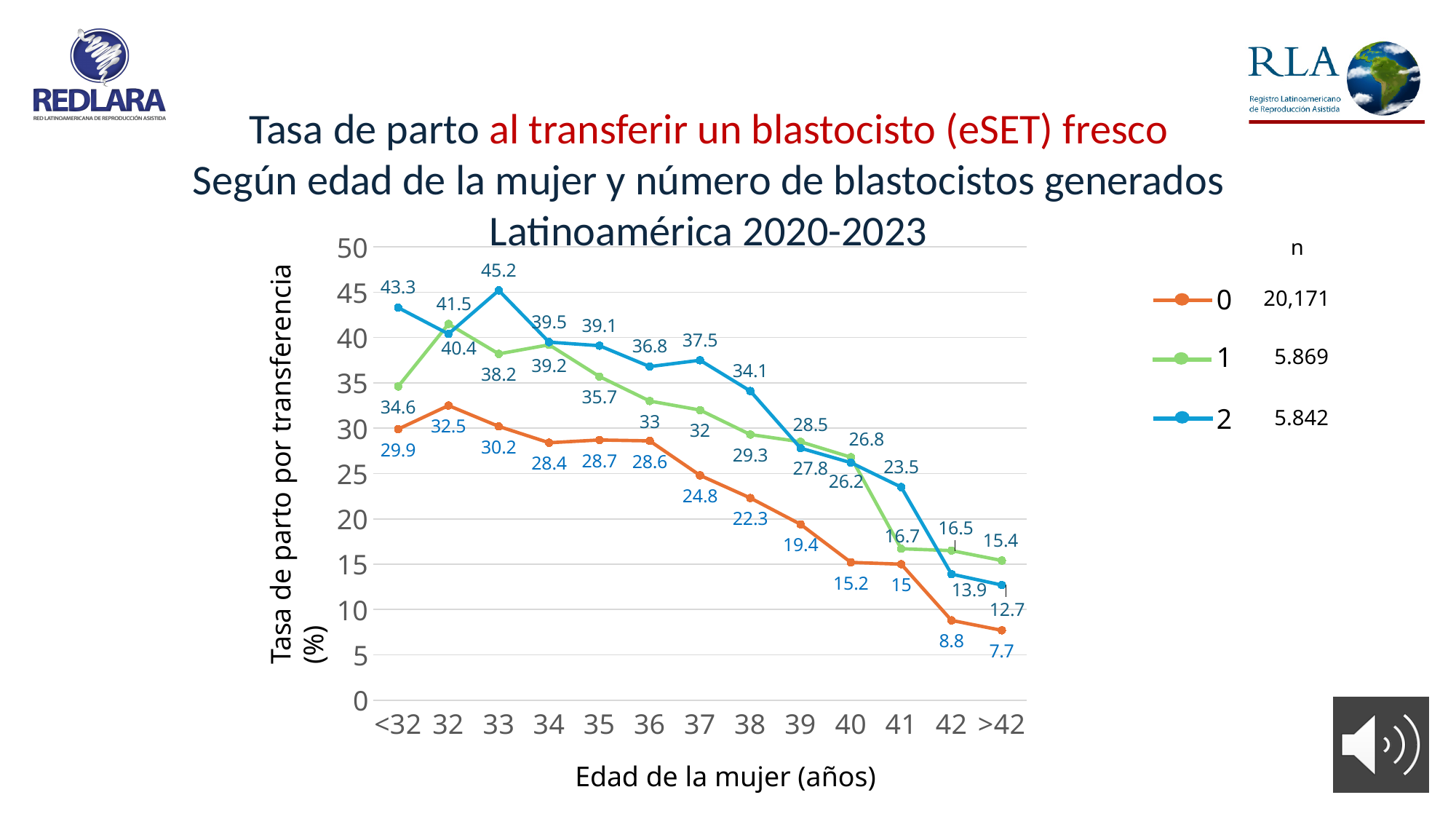
What type of chart is shown on the slide? line chart Which series has the larger value at age 41, series 1 or series 2? series 2 How many series does the legend list? 3 At which age category does series 2 reach its highest value? 33 What is the overall trend of series 0 as the age of the woman increases? falls What is the n value shown in the legend for series 0? 20,171 What is the value for series 1 at age 32? 41.5 What is the difference between series 2 and series 0 at age <32? 13.4 At which age category does series 0 have its lowest value? >42 How many age categories are shown on the x axis? 13 What is the value for series 2 at age 33? 45.2 What is the value for series 0 at age >42? 7.7